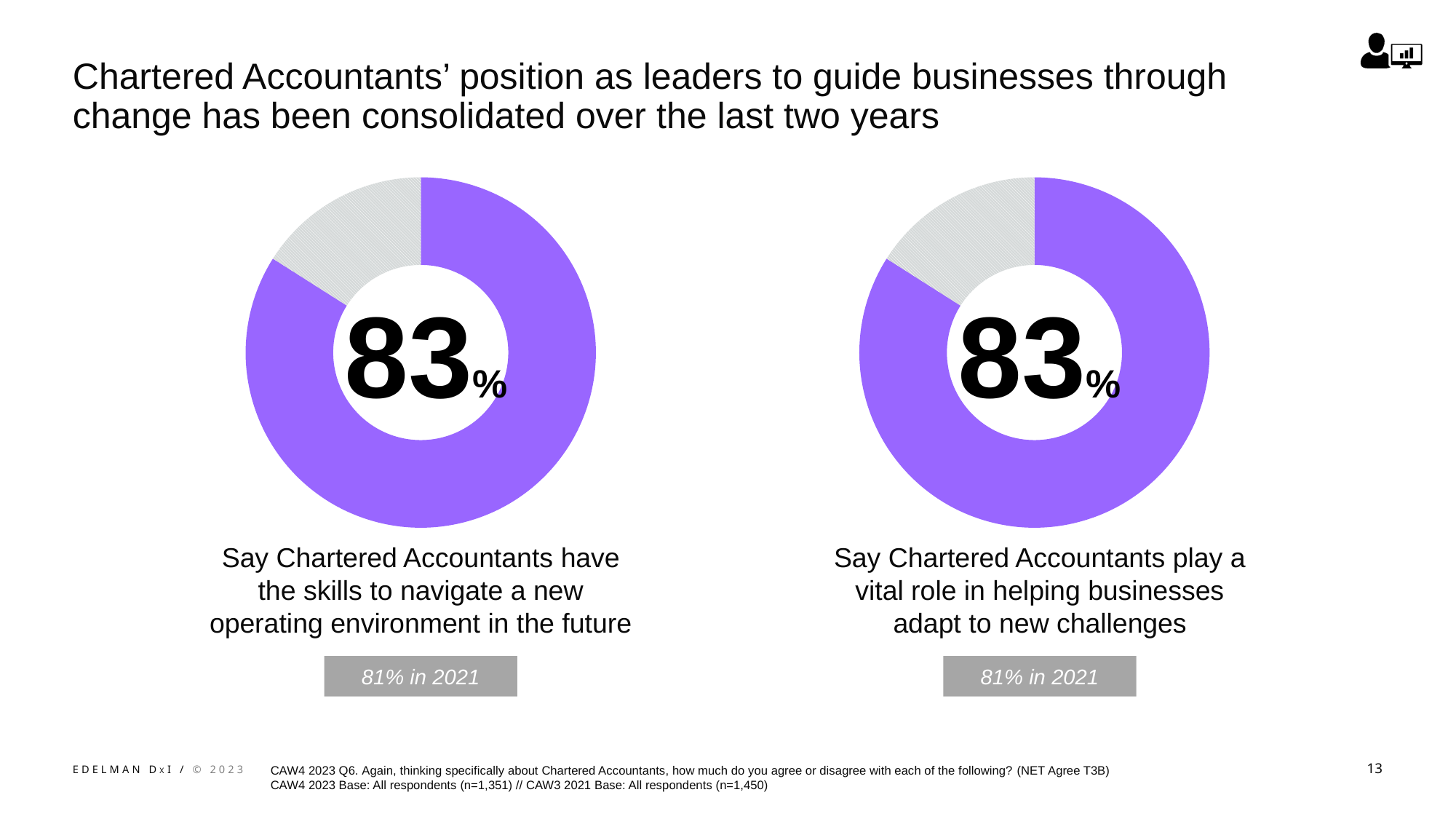
In the left donut chart, what share of the ring is not filled by the purple 83% segment? 17% Is the value shown in the right donut chart greater or less than 80%? greater For the right chart, by how many percentage points did the value change from 2021 to the current 83%? 2 percentage points In the right donut chart, what percentage say Chartered Accountants play a vital role in helping businesses adapt to new challenges? 83% For the left chart, by how many percentage points did the value change from 2021 to the current 83%? 2 percentage points What colour is used for the main (83%) segment in both donut charts? Purple For the right chart (vital role in helping businesses adapt), what was the value in 2021? 81% Is the value in the left donut chart higher, lower, or the same as the value in the right donut chart? The same For the left chart (skills to navigate a new operating environment), what was the value in 2021? 81% What kind of chart is used on the left of the slide? Donut (pie) chart In the left donut chart, what percentage say Chartered Accountants have the skills to navigate a new operating environment in the future? 83% How many donut charts are shown on the slide? 2